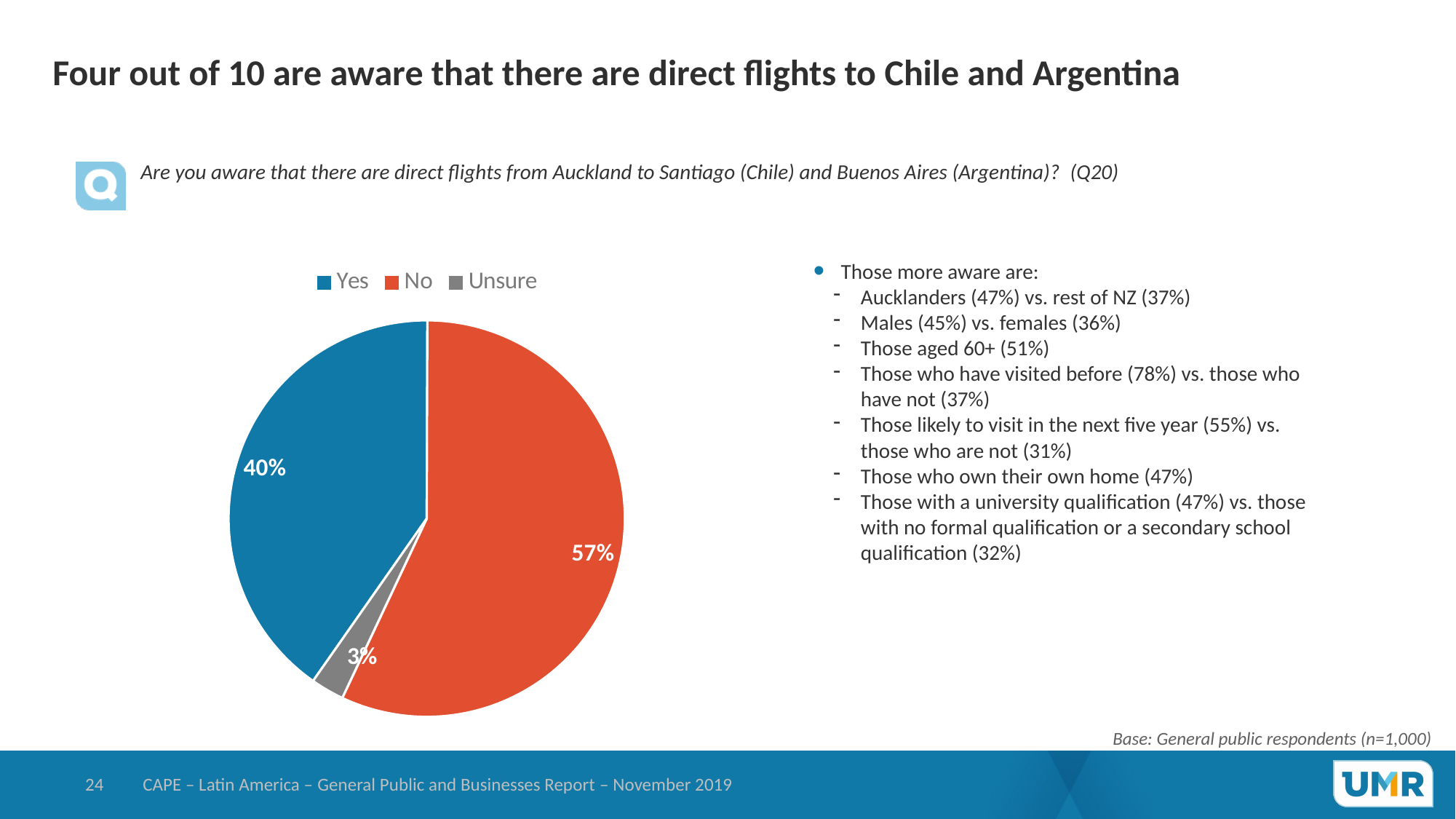
Which is larger, the Yes slice or the No slice? No How many entries does the legend list? 3 What percentage of respondents answered No? 57% How many slices does the pie chart have? 3 What kind of chart is shown on the slide? Pie chart What colour is the No slice in the pie chart? Orange-red What colour is the Yes slice in the pie chart? Blue Which response has the largest share of the pie? No Which response has the smallest share of the pie? Unsure What percentage of respondents answered Unsure? 3% What is the difference in percentage points between the No and Yes slices? 17 What percentage of respondents answered Yes? 40%